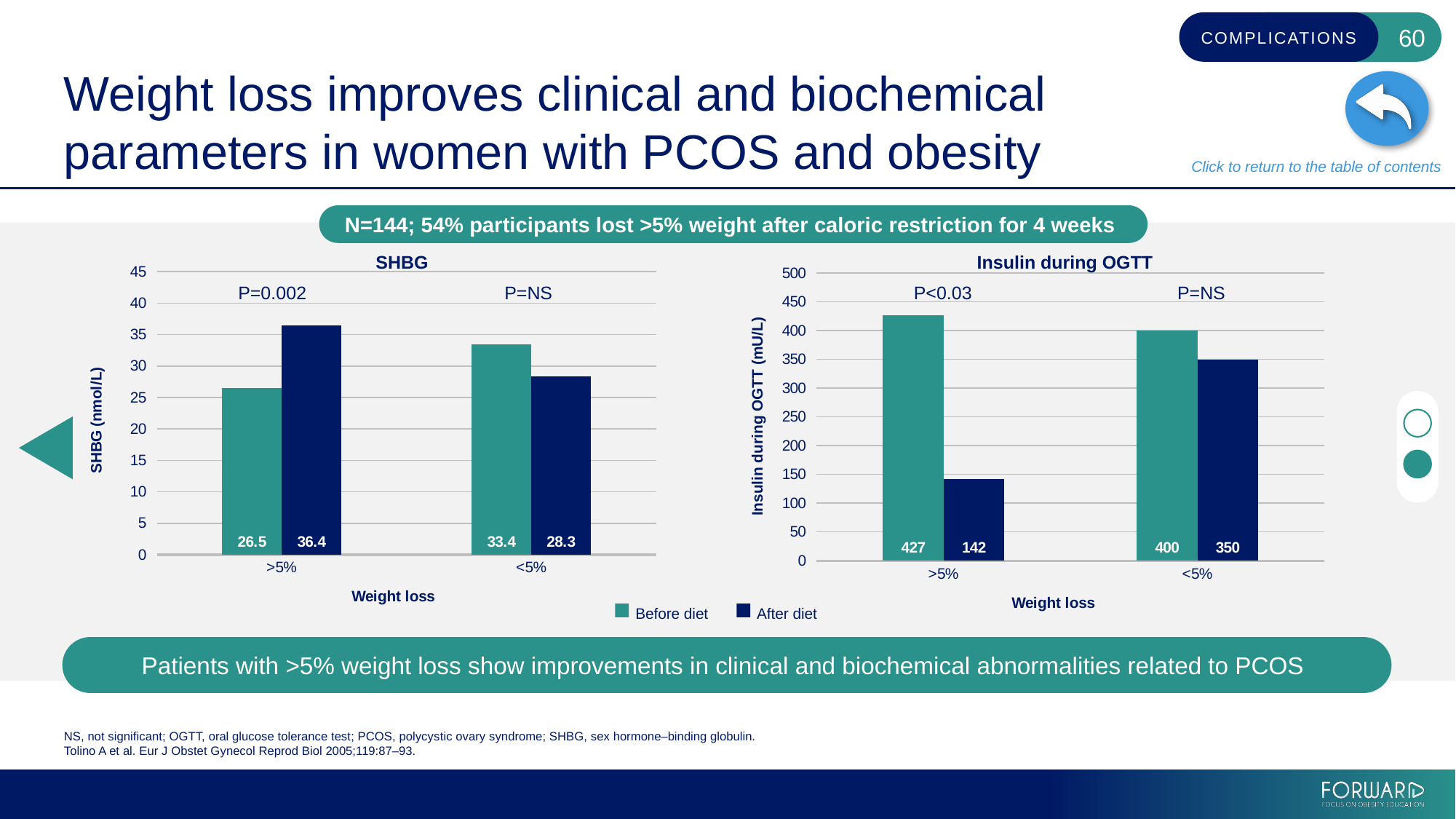
In the Insulin during OGTT chart, what is the value for After diet in the >5% weight loss group? 142 How many series does the legend list? 2 In the SHBG chart, what is the value for Before diet in the >5% weight loss group? 26.5 In the Insulin during OGTT chart, which bar has the highest value? Before diet, >5% In the Insulin during OGTT chart, what is the value for Before diet in the <5% weight loss group? 400 What kind of chart is the Insulin during OGTT chart? Bar chart In the SHBG chart, what is the difference between After diet and Before diet in the >5% weight loss group? 9.9 In the SHBG chart, which is larger in the <5% weight loss group: Before diet or After diet? Before diet In the SHBG chart, what is the value for After diet in the <5% weight loss group? 28.3 In the Insulin during OGTT chart, what is the difference between Before diet and After diet in the >5% weight loss group? 285 In the SHBG chart, which bar has the lowest value? Before diet, >5% What is the y-axis label of the SHBG chart? SHBG (nmol/L)